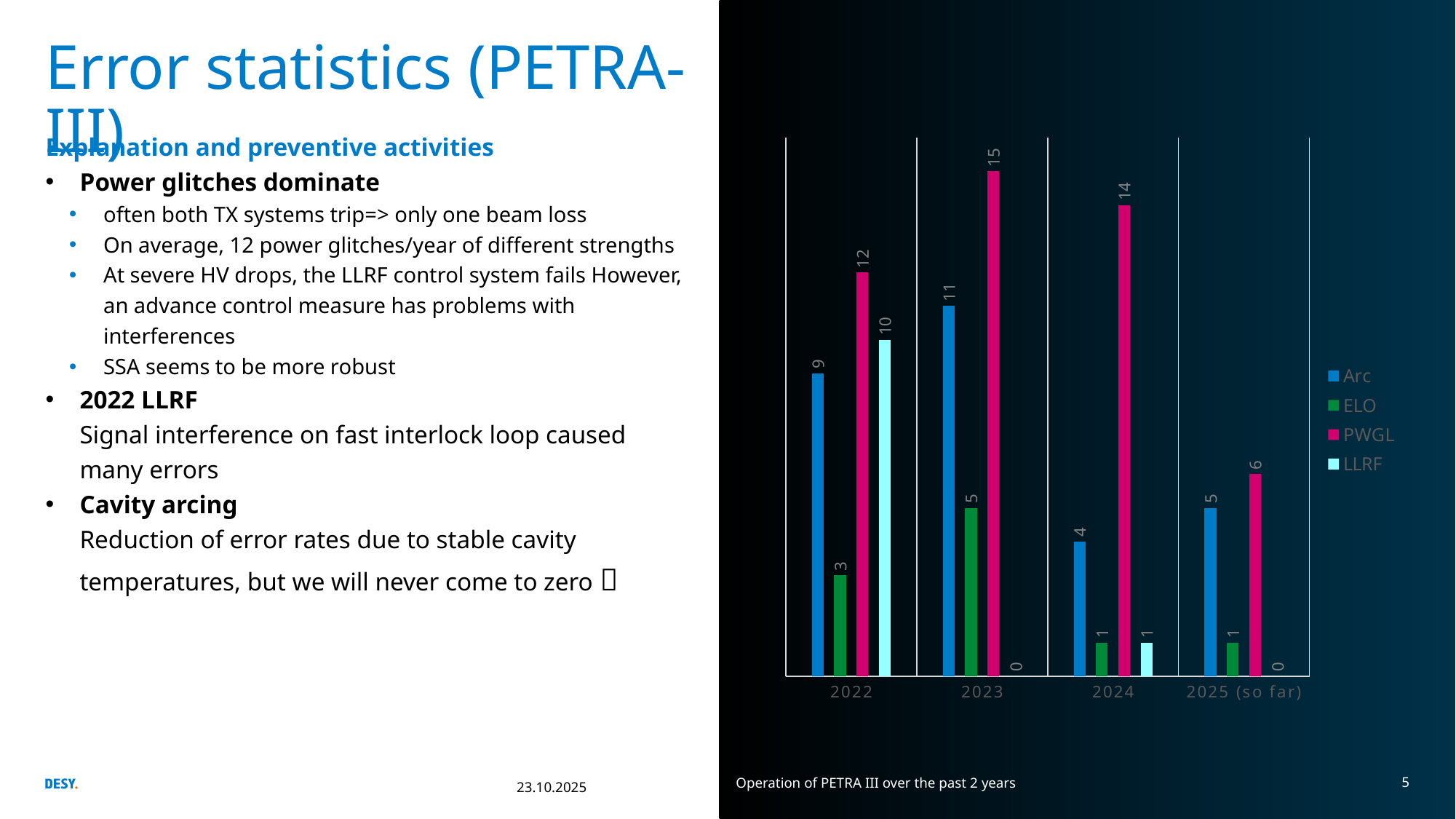
What is the LLRF value for 2024? 1 In which year is the Arc value lowest? 2024 What is the difference between the PWGL value and the Arc value in 2024? 10 Which is larger in 2022, the PWGL value or the LLRF value? PWGL In which year is the PWGL value highest? 2023 How many year categories are shown on the x axis? 4 What is the PWGL value for 2023? 15 Does the ELO value rise or fall from 2023 to 2024? Fall How many series does the legend list? 4 What kind of chart is shown on the slide? Bar chart What is the Arc value for 2022? 9 What is the ELO value for 2025 (so far)? 1